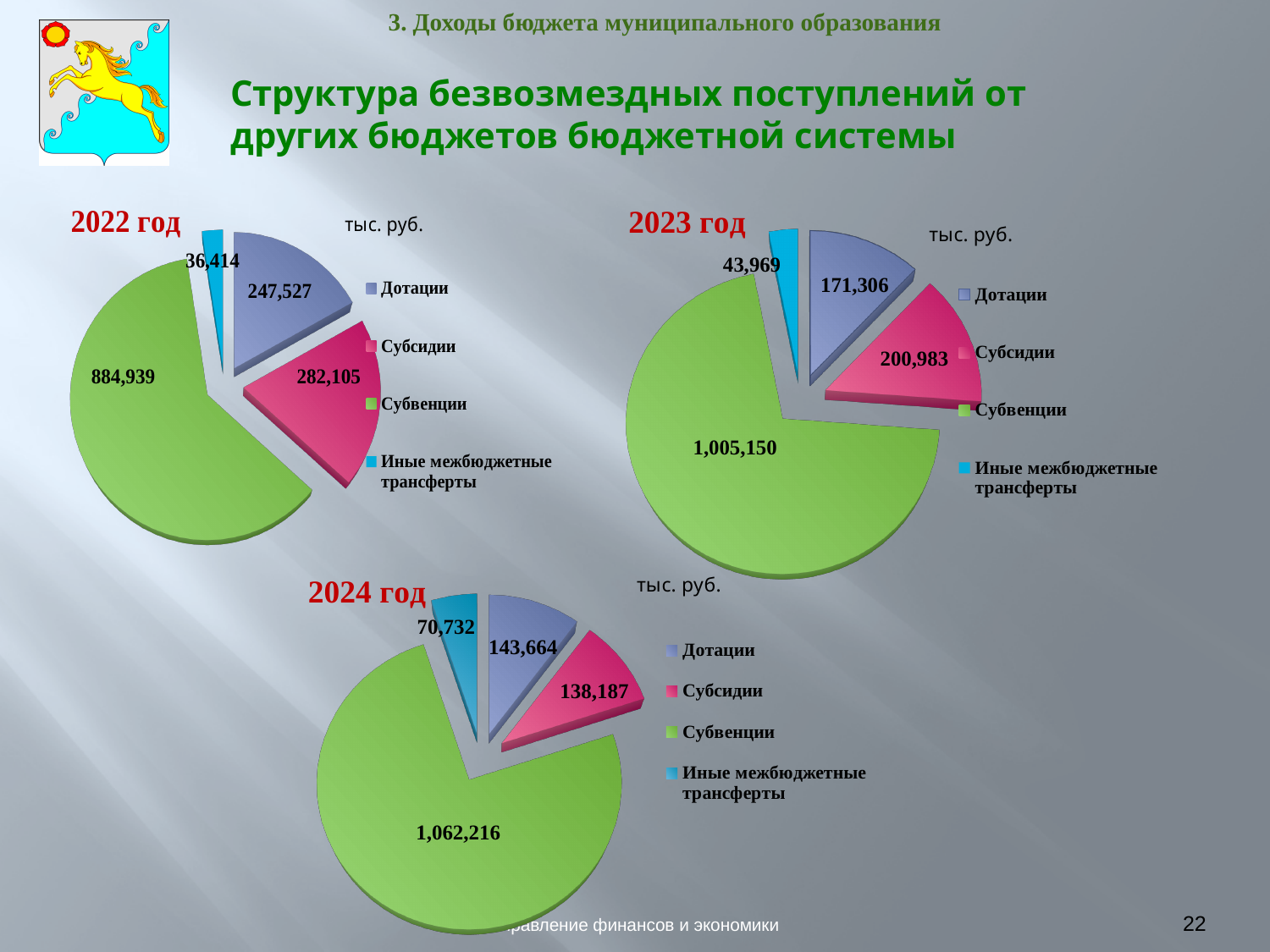
In the 2023 год pie chart, what is the value for Субсидии? 200,983 In the 2024 год pie chart, what is the value for Иные межбюджетные трансферты? 70,732 In the 2022 год pie chart, what is the difference between Субсидии and Дотации? 34,578 In the 2022 год pie chart, which category has the smallest value? Иные межбюджетные трансферты In the 2022 год pie chart, what is the value for Субвенции? 884,939 In the 2024 год pie chart, which category has the largest value? Субвенции In the 2023 год pie chart, what is the value for Дотации? 171,306 What type of chart is used for the 2024 год data? Pie chart How many slices does the 2023 год pie chart have? 4 What unit is shown next to each of the three pie charts? тыс. руб. In the 2024 год pie chart, what is the difference between Дотации and Субсидии? 5,477 In the 2023 год pie chart, which is larger, Дотации or Субсидии? Субсидии